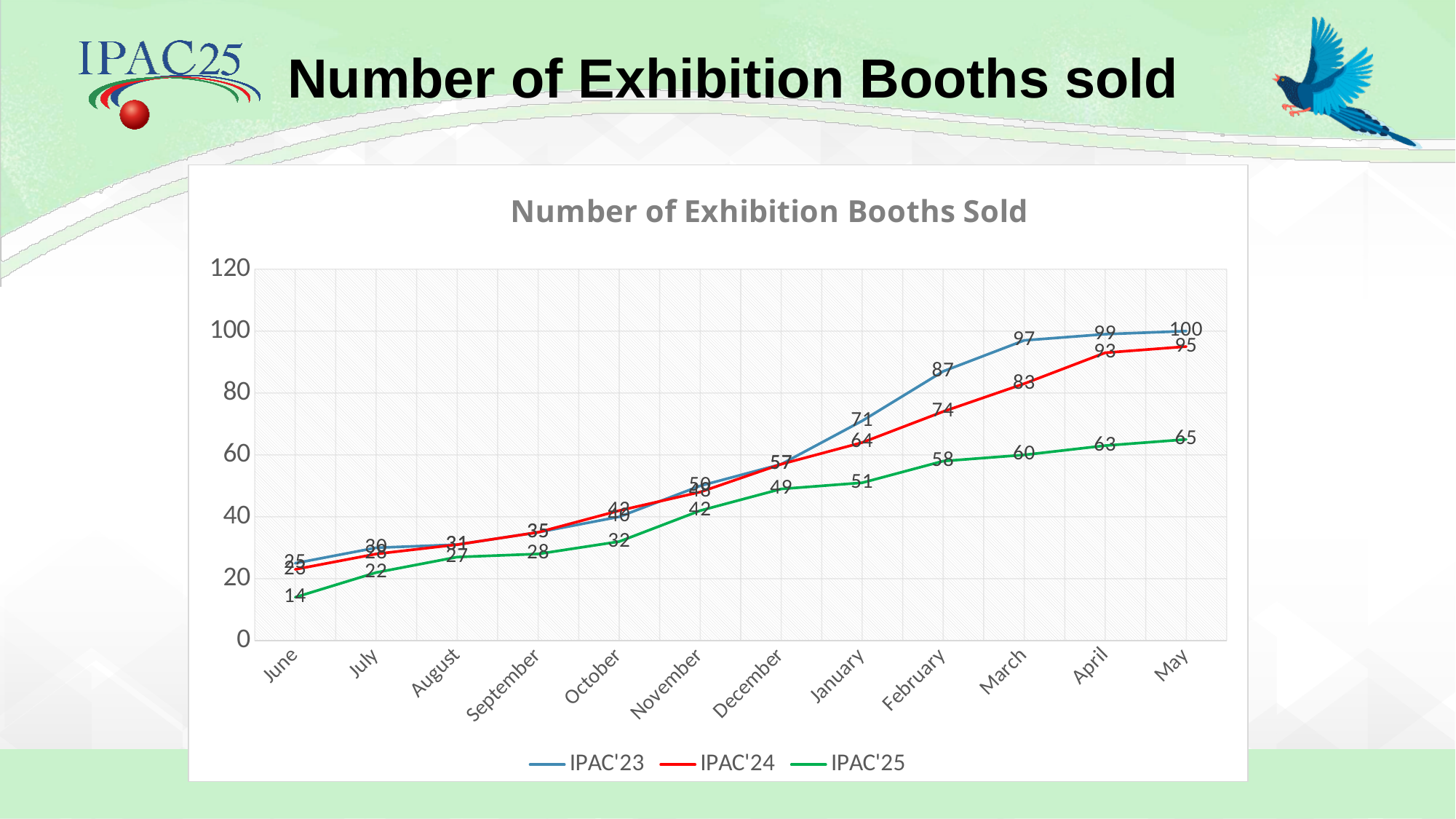
What is the value for IPAC'25 in June? 14 What is the value for IPAC'24 in March? 83 Do the IPAC'25 values rise or fall from June to May? rise In February, which series has the larger value, IPAC'23 or IPAC'24? IPAC'23 How many months are plotted along the x axis? 12 What kind of chart is shown on the slide? line chart Is the value for IPAC'24 in October greater or less than 60? less What is the value for IPAC'23 in May? 100 In which month does the IPAC'25 series reach its highest value? May What is the difference between IPAC'23 and IPAC'24 in May? 5 How many series does the legend list? 3 What colour is the IPAC'24 line? red